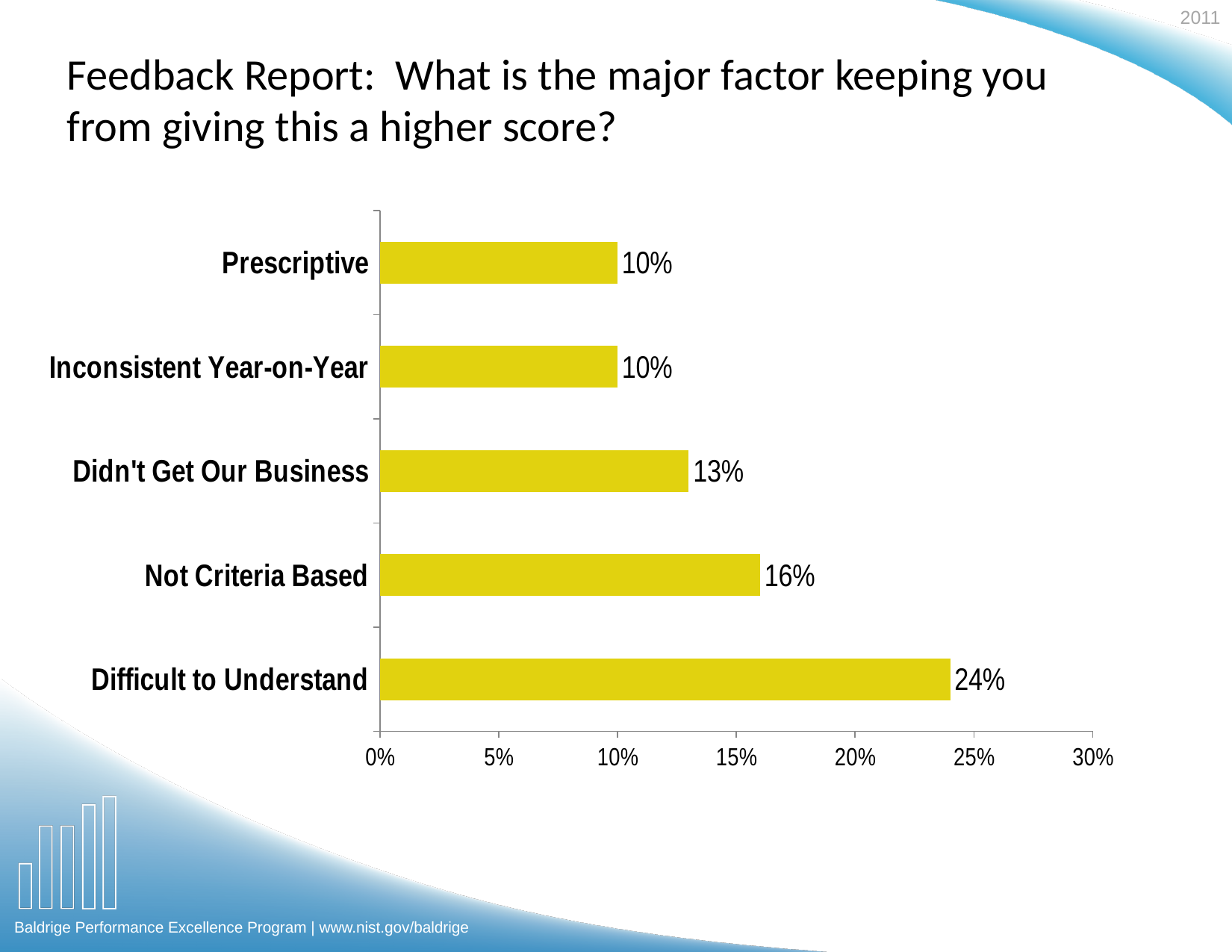
Which category has the highest value? Difficult to Understand What is the maximum value shown on the horizontal axis? 30% What is the value for Difficult to Understand? 24% What is the value for Prescriptive? 10% What kind of chart is shown on the slide? Bar chart What is the value for Didn't Get Our Business? 13% How many categories are shown in the chart? 5 What is the difference between Difficult to Understand and Not Criteria Based? 8% What is the value for Not Criteria Based? 16% Is the value for Difficult to Understand greater or less than 20%? greater Which is larger, Didn't Get Our Business or Inconsistent Year-on-Year? Didn't Get Our Business What is the difference between Not Criteria Based and Didn't Get Our Business? 3%